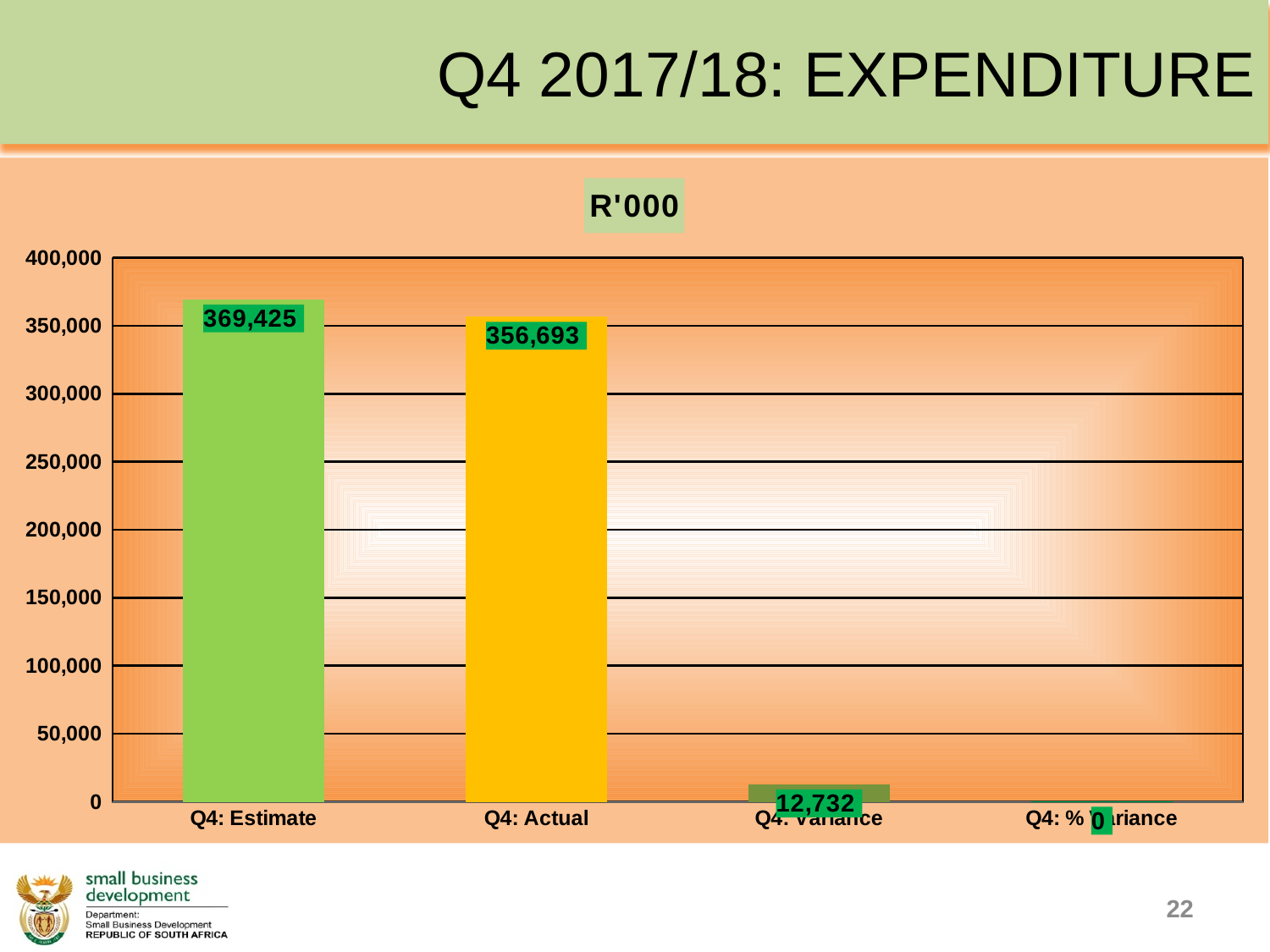
What is the value shown for Q4: % Variance? 0 What is the value for Q4: Actual? 356,693 Which is larger, Q4: Estimate or Q4: Actual? Q4: Estimate Which category has the highest value? Q4: Estimate What kind of chart is shown on the slide? Bar chart What is the title of the chart? R'000 What is the value for Q4: Estimate? 369,425 Is the value for Q4: Actual greater or less than 300,000? greater Which category has the lowest value? Q4: % Variance How many categories are shown on the x axis? 4 What is the difference between Q4: Estimate and Q4: Actual? 12,732 What is the value for Q4: Variance? 12,732